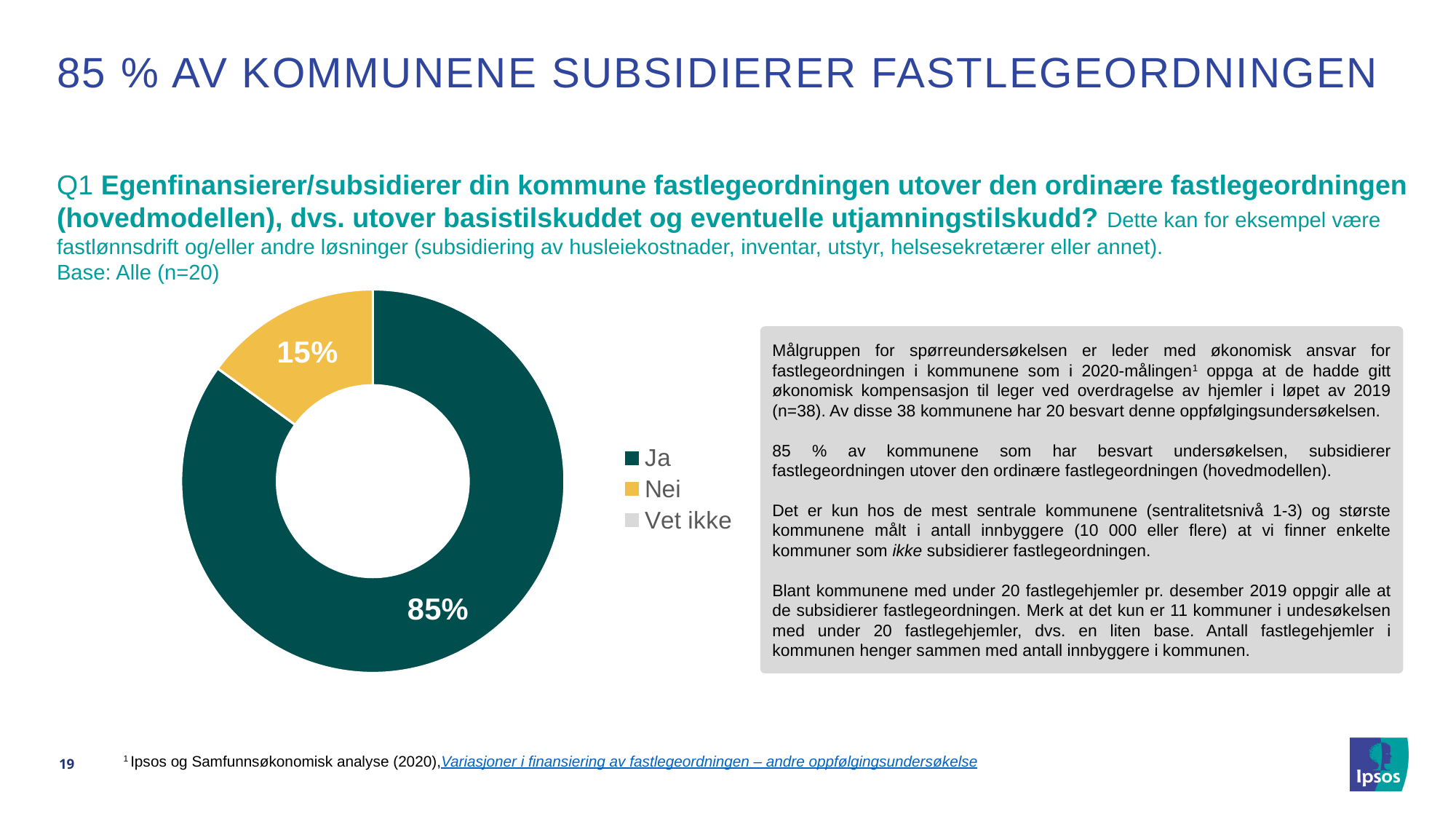
What kind of chart is shown on the slide? pie chart (donut) What is the base (n) stated for the chart? n=20 Which of the two labelled slices, "Ja" or "Nei", is smaller? Nei What colour is the "Nei" slice in the pie chart? yellow What percentage of the pie chart is labelled "Ja"? 85% What do the two labelled slices "Ja" and "Nei" add up to? 100% How many entries does the chart legend list? 3 What is the difference in percentage points between the "Ja" slice and the "Nei" slice? 70 percentage points Which category has the largest slice in the pie chart? Ja Is the "Ja" slice larger or smaller than the "Nei" slice? larger What percentage of the pie chart is labelled "Nei"? 15% What share of the pie does the "Ja" slice represent? 85%